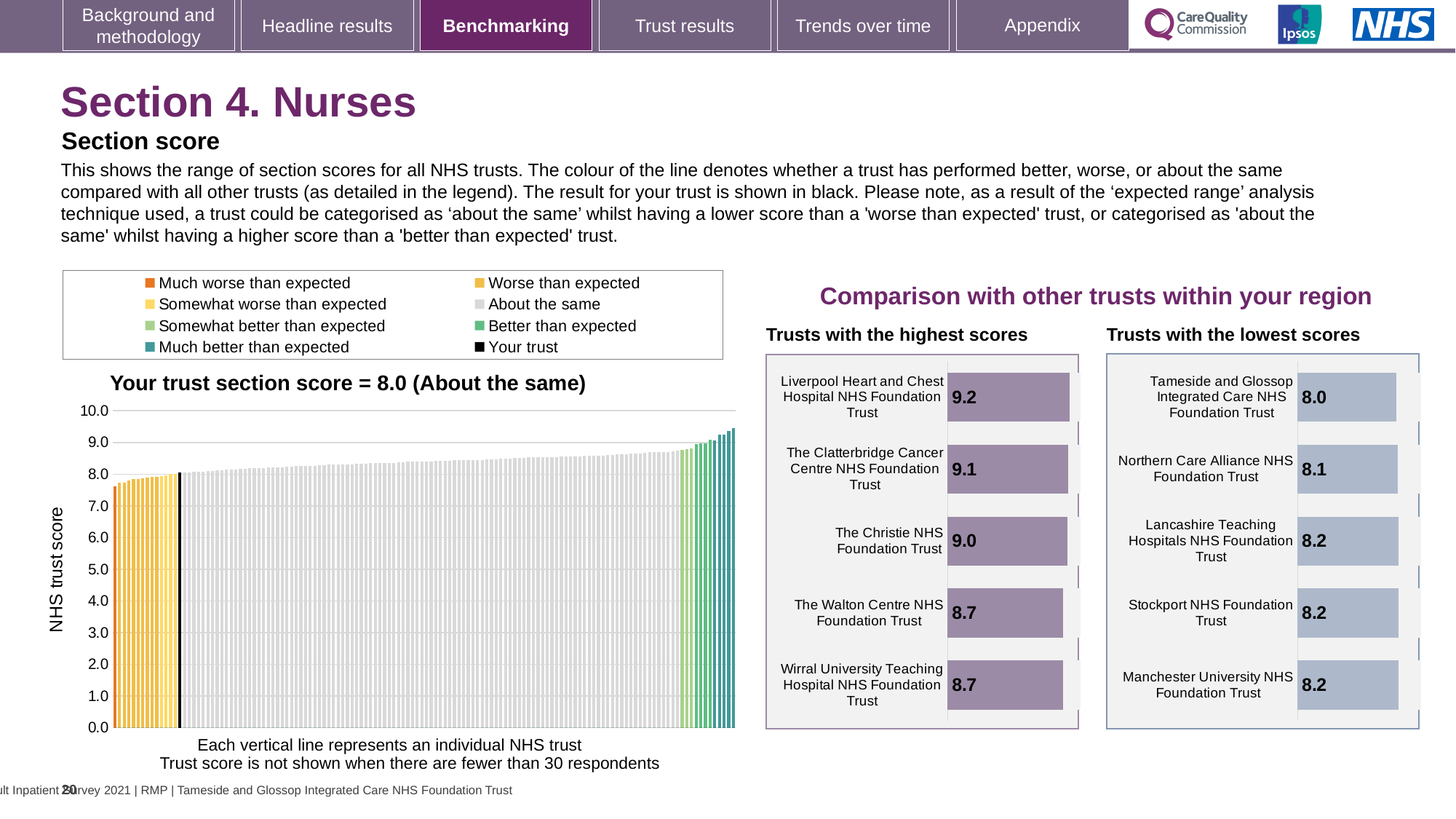
In the 'Trusts with the lowest scores' chart, what is the difference between the scores of Lancashire Teaching Hospitals NHS Foundation Trust and Tameside and Glossop Integrated Care NHS Foundation Trust? 0.2 How many entries does the legend of the main chart showing all NHS trusts list? 8 In the main chart showing all NHS trusts, what is the section score for your trust? 8.0 In the 'Trusts with the lowest scores' chart, what is the score for Northern Care Alliance NHS Foundation Trust? 8.1 In the 'Trusts with the highest scores' chart, what is the score for Liverpool Heart and Chest Hospital NHS Foundation Trust? 9.2 In the 'Trusts with the lowest scores' chart, which has the larger score: Stockport NHS Foundation Trust or Tameside and Glossop Integrated Care NHS Foundation Trust? Stockport NHS Foundation Trust How many trusts are shown in the 'Trusts with the highest scores' chart? 5 In the main chart showing all NHS trusts, is the value of the highest bar greater or less than 9.0? greater In the 'Trusts with the highest scores' chart, which trust has the highest score? Liverpool Heart and Chest Hospital NHS Foundation Trust In the 'Trusts with the highest scores' chart, what is the score for The Christie NHS Foundation Trust? 9.0 In the 'Trusts with the lowest scores' chart, which trust has the lowest score? Tameside and Glossop Integrated Care NHS Foundation Trust In the 'Trusts with the highest scores' chart, what is the difference between the scores of Liverpool Heart and Chest Hospital NHS Foundation Trust and The Walton Centre NHS Foundation Trust? 0.5